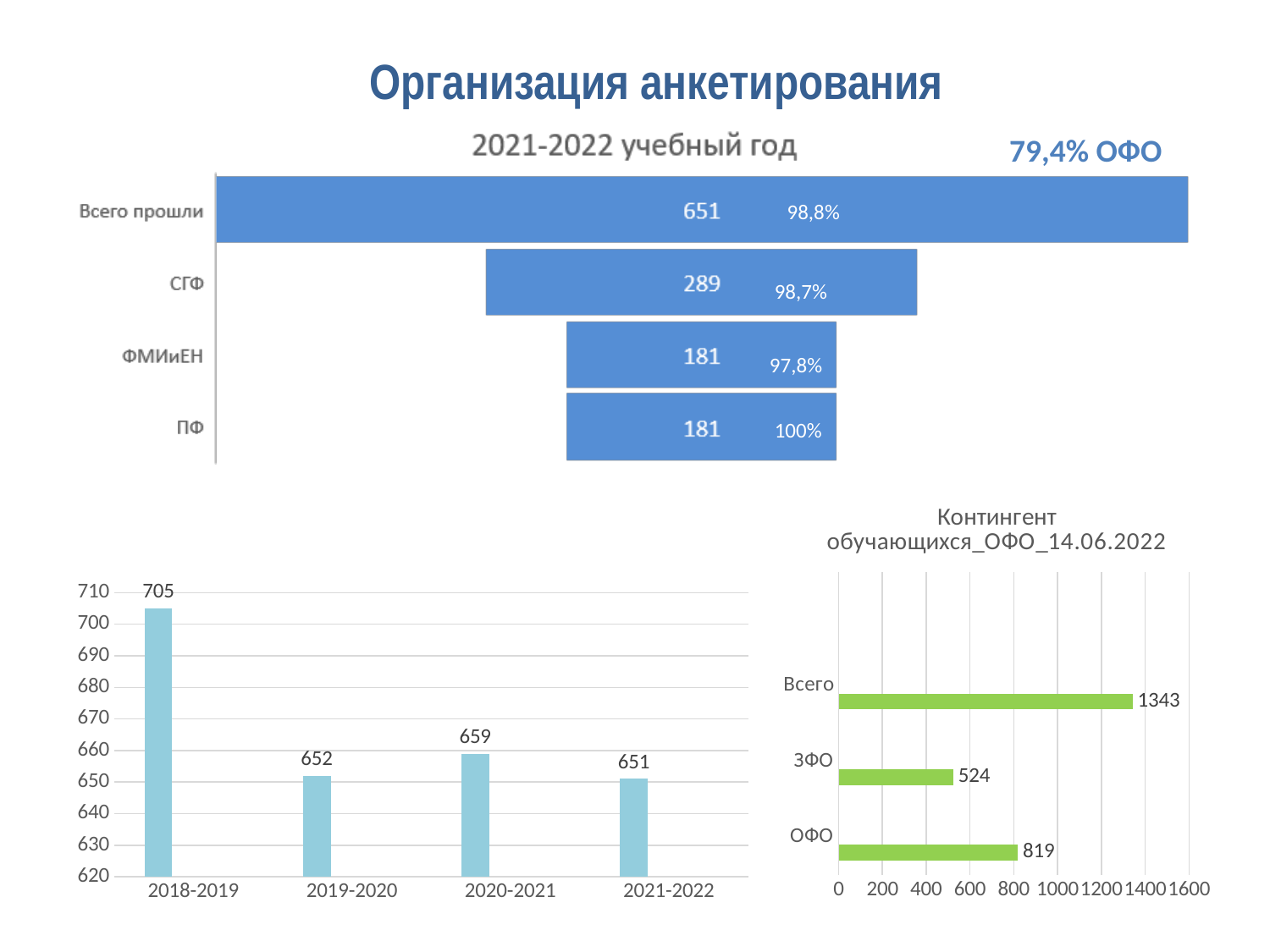
In the chart titled 'Контингент обучающихся_ОФО_14.06.2022', what is the value for ЗФО? 524 In the chart titled '2021-2022 учебный год', what is the difference between the values for СГФ and ФМИиЕН? 108 In the chart titled '2021-2022 учебный год', what is the value for СГФ? 289 In the chart titled '2021-2022 учебный год', what percentage is shown for ПФ? 100% In the bottom-left chart, which year has the highest value? 2018-2019 In the chart titled '2021-2022 учебный год', how many categories are shown? 4 What kind of chart is the chart titled 'Контингент обучающихся_ОФО_14.06.2022'? bar chart In the bottom-left chart, which year has the lowest value? 2021-2022 In the chart titled 'Контингент обучающихся_ОФО_14.06.2022', which is larger, ОФО or ЗФО? ОФО In the chart titled '2021-2022 учебный год', what is the value for Всего прошли? 651 In the bottom-left chart, what is the value for 2020-2021? 659 In the bottom-left chart, what is the difference between the values for 2018-2019 and 2019-2020? 53